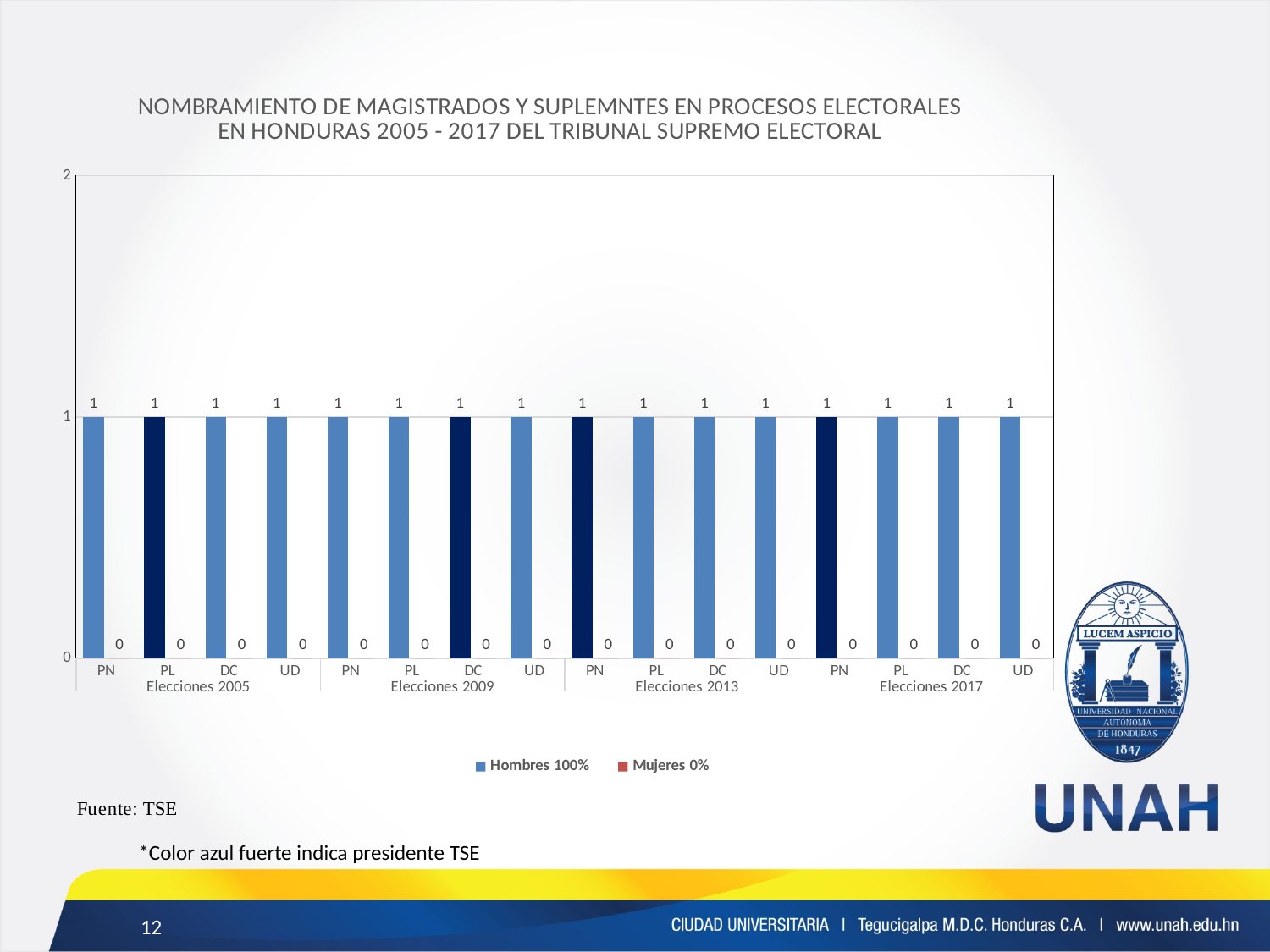
Which is larger for PL in Elecciones 2013, the Hombres value or the Mujeres value? Hombres What type of chart is shown on the slide? Bar chart What is the Mujeres value for UD in Elecciones 2017? 0 How many series does the legend list? 2 What are the two legend entries of the chart? Hombres 100% and Mujeres 0% What is the Mujeres value for PL in Elecciones 2009? 0 How many party categories are shown within each election group? 4 How many election years are shown along the x axis? 4 According to the note below the chart, what does the strong blue colour indicate? Presidente TSE What is the difference between the Hombres and Mujeres values for UD in Elecciones 2009? 1 What is the Hombres value for DC in Elecciones 2013? 1 What is the Hombres value for PN in Elecciones 2005? 1